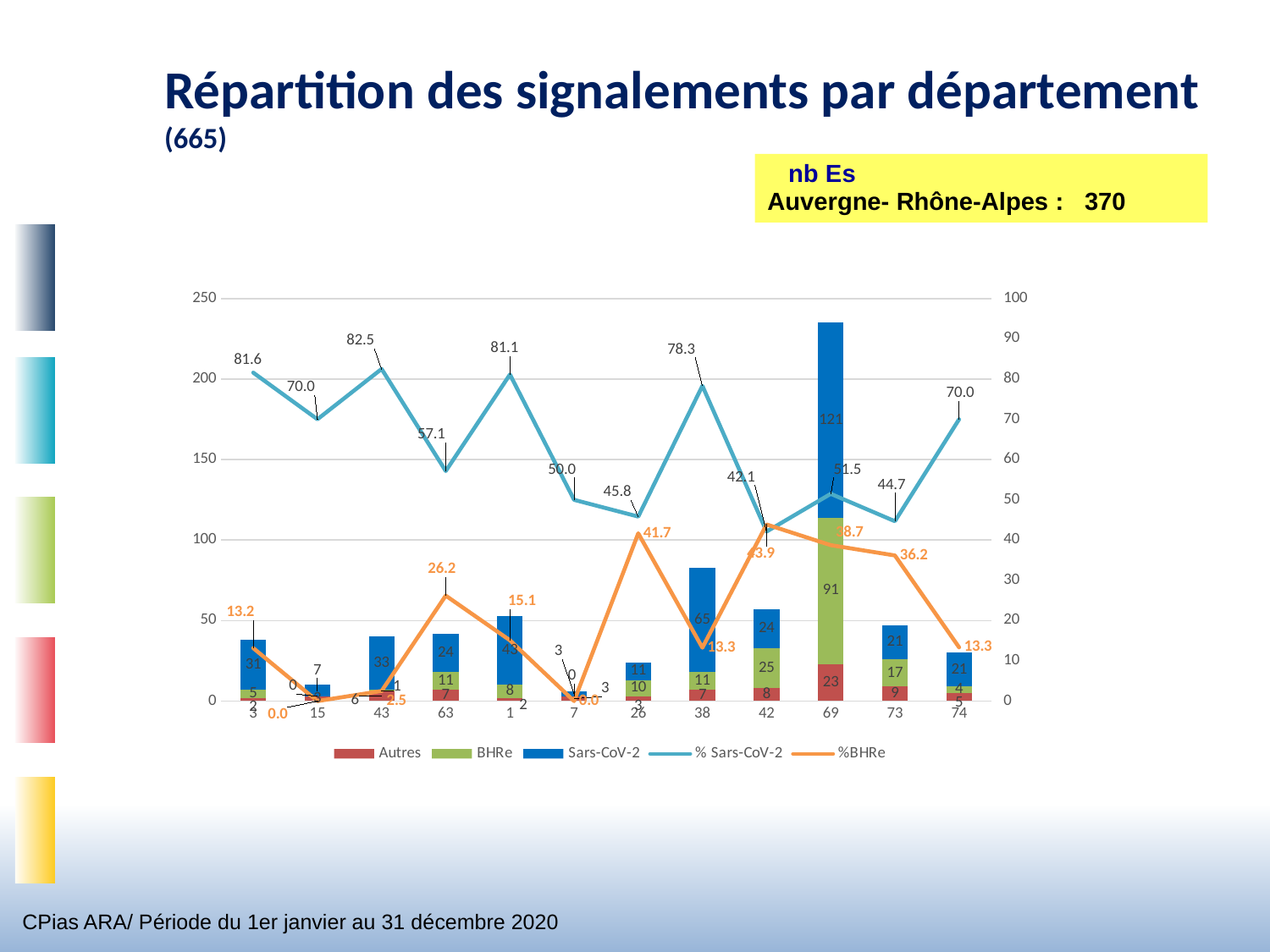
What is the BHRe value for department 69? 91 How many series does the legend list? 5 What is the Sars-CoV-2 value for department 69? 121 Which department has the lowest % Sars-CoV-2 value? 42 What is the % Sars-CoV-2 value for department 43? 82.5 Which is larger, the Sars-CoV-2 value for department 3 or for department 43? 43 What is the total of the stacked bar for department 63? 42 Which department has the highest Sars-CoV-2 value? 69 What is the %BHRe value for department 26? 41.7 What is the difference between the Sars-CoV-2 values for departments 69 and 38? 56 Is the total of the stacked bar for department 69 greater or less than 200? greater How many departments are shown on the x axis? 12